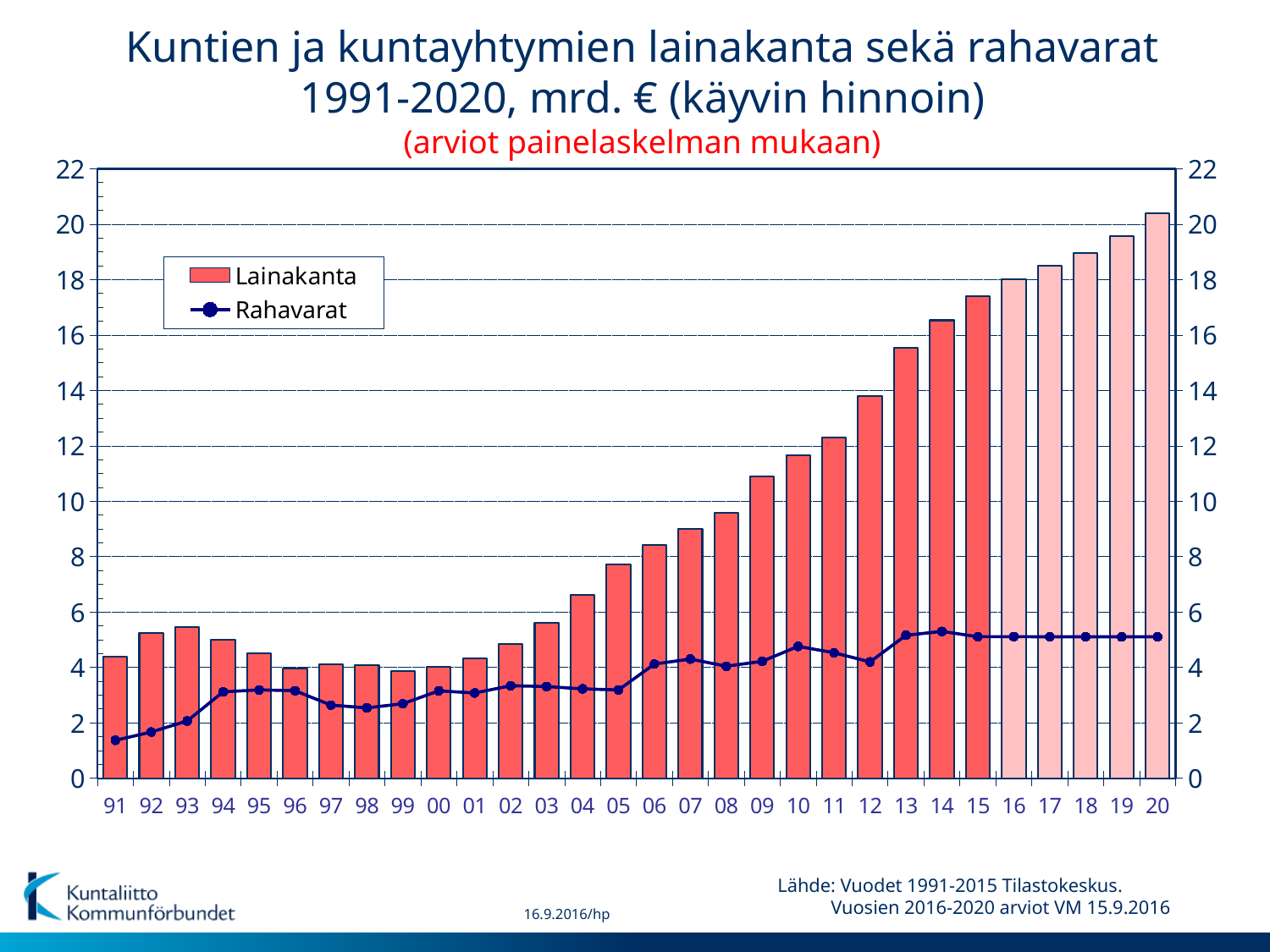
Is the Lainakanta value for 10 greater or less than 12? less What kind of chart is shown on the slide? A bar chart combined with a line chart Is the Lainakanta value for 13 greater or less than 14? greater How many series does the legend list? 2 Is the Rahavarat value for 10 greater or less than 4? greater Does the Lainakanta series rise or fall from 05 to 20? rise Which year has the lowest Rahavarat value? 91 What are the two series named in the legend? Lainakanta and Rahavarat Which is larger, the Lainakanta value for 15 or for 10? 15 How many years are shown on the x axis? 30 Which year has the highest Lainakanta bar? 20